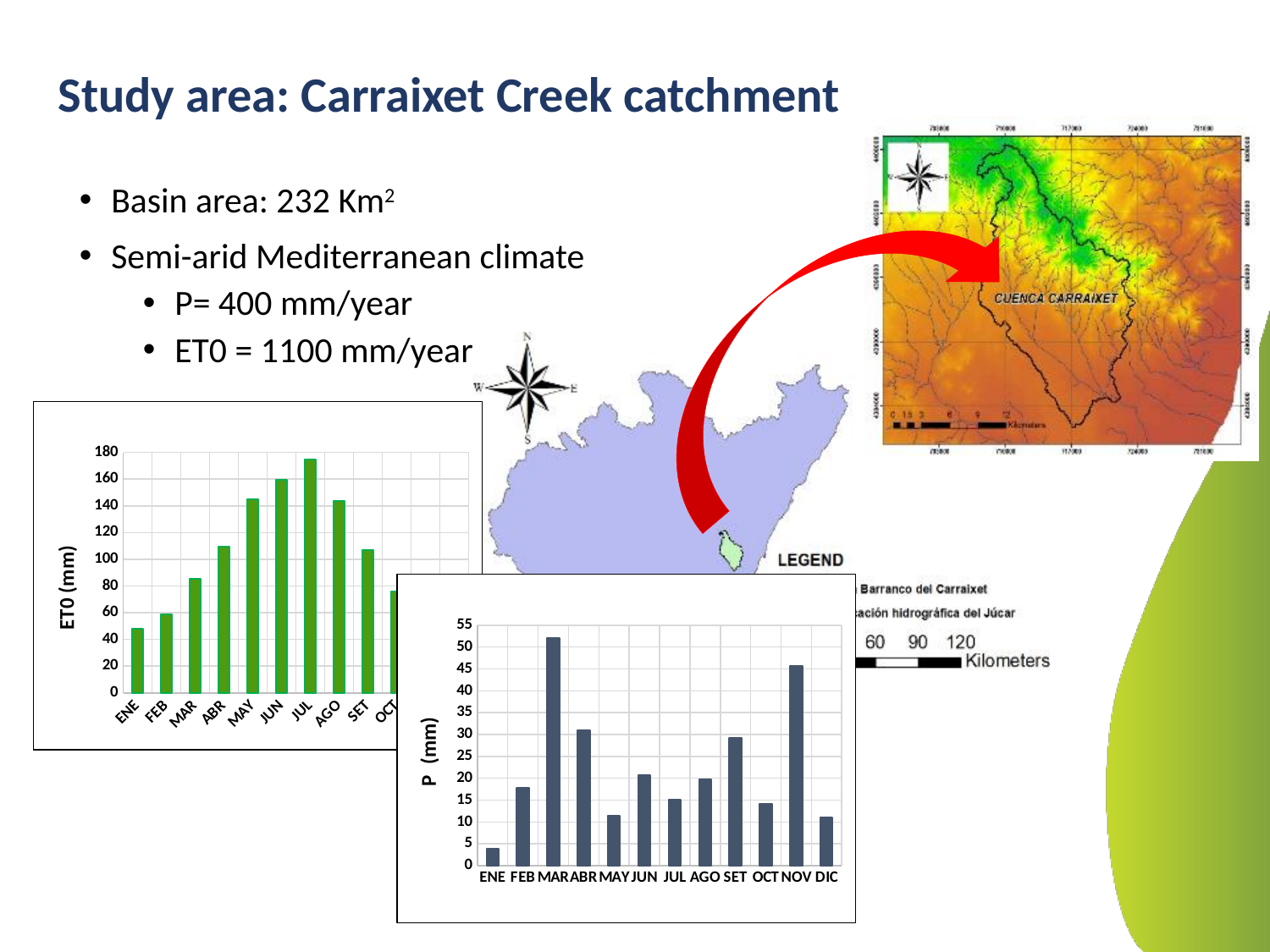
What kind of chart is the P (mm) chart at the bottom of the slide? bar chart In the ET0 (mm) chart, is the value for ABR greater or less than 100? greater In the P (mm) chart, which month has a larger value, ENE or DIC? DIC What colour are the bars in the ET0 (mm) chart? green In the ET0 (mm) chart, do the values rise or fall from ENE to JUL? rise In the ET0 (mm) chart, which month has the highest value? JUL In the P (mm) chart, is the value for NOV greater or less than 40? greater In the P (mm) chart, which month has a larger value, MAR or NOV? MAR In the P (mm) chart, which month has the highest precipitation? MAR In the P (mm) chart, is the value for MAY greater or less than 10? greater How many months are shown on the x axis of the P (mm) chart? 12 In the P (mm) chart, which month has the lowest precipitation? ENE